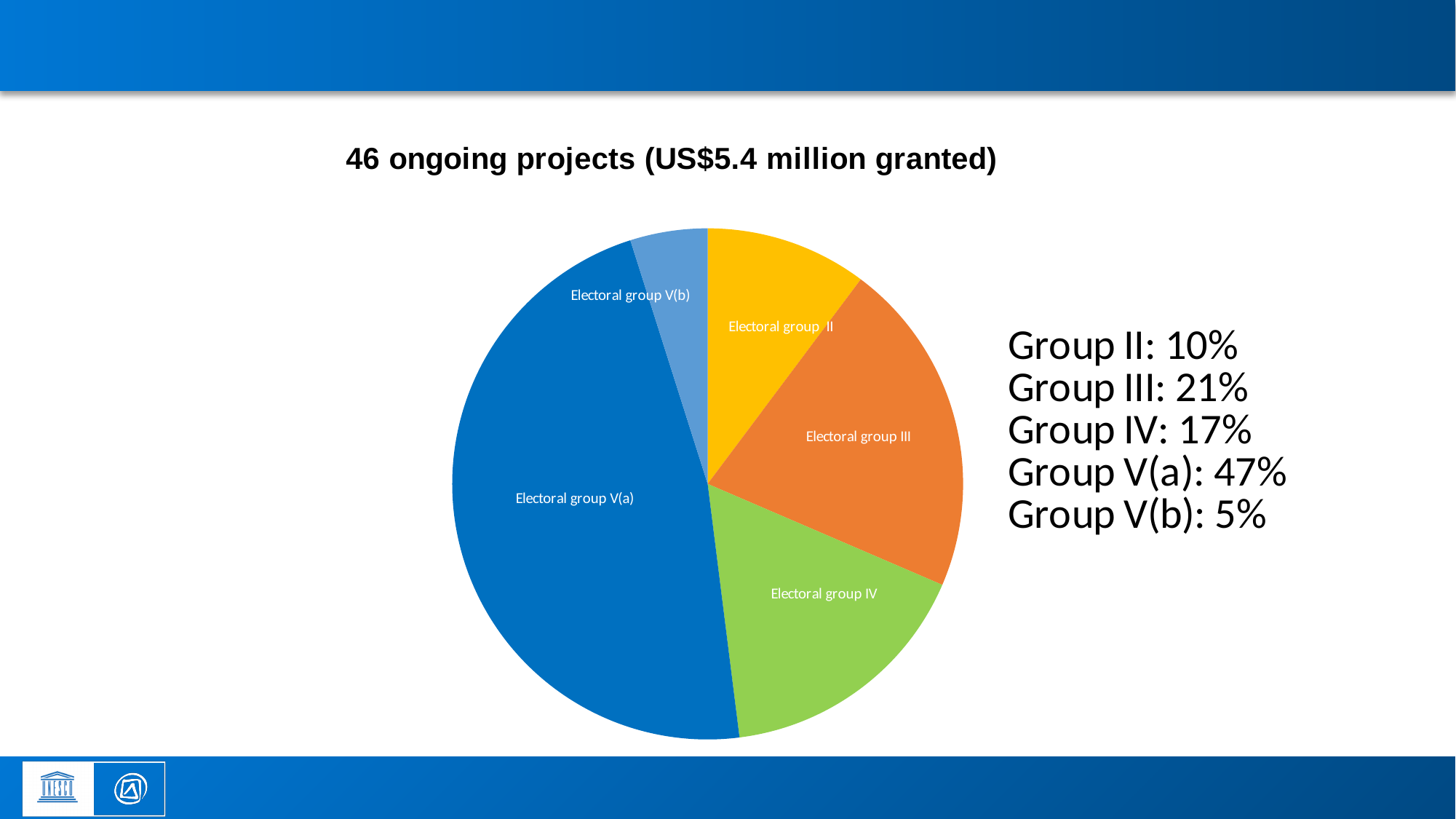
Which electoral group has the largest slice of the pie chart? Electoral group V(a) What is the difference in percentage points between Electoral group V(a) and Electoral group III? 26 What share of the pie does Electoral group V(b) represent? 5% What share of the pie does Electoral group III represent? 21% Which electoral group has the smallest slice of the pie chart? Electoral group V(b) What share of the pie does Electoral group V(a) represent? 47% How many slices does the pie chart have? 5 What is the difference in percentage points between Electoral group IV and Electoral group II? 7 Which slice is larger, Electoral group III or Electoral group IV? Electoral group III What kind of chart is shown on the slide? pie chart What is the title of the chart? 46 ongoing projects (US$5.4 million granted)